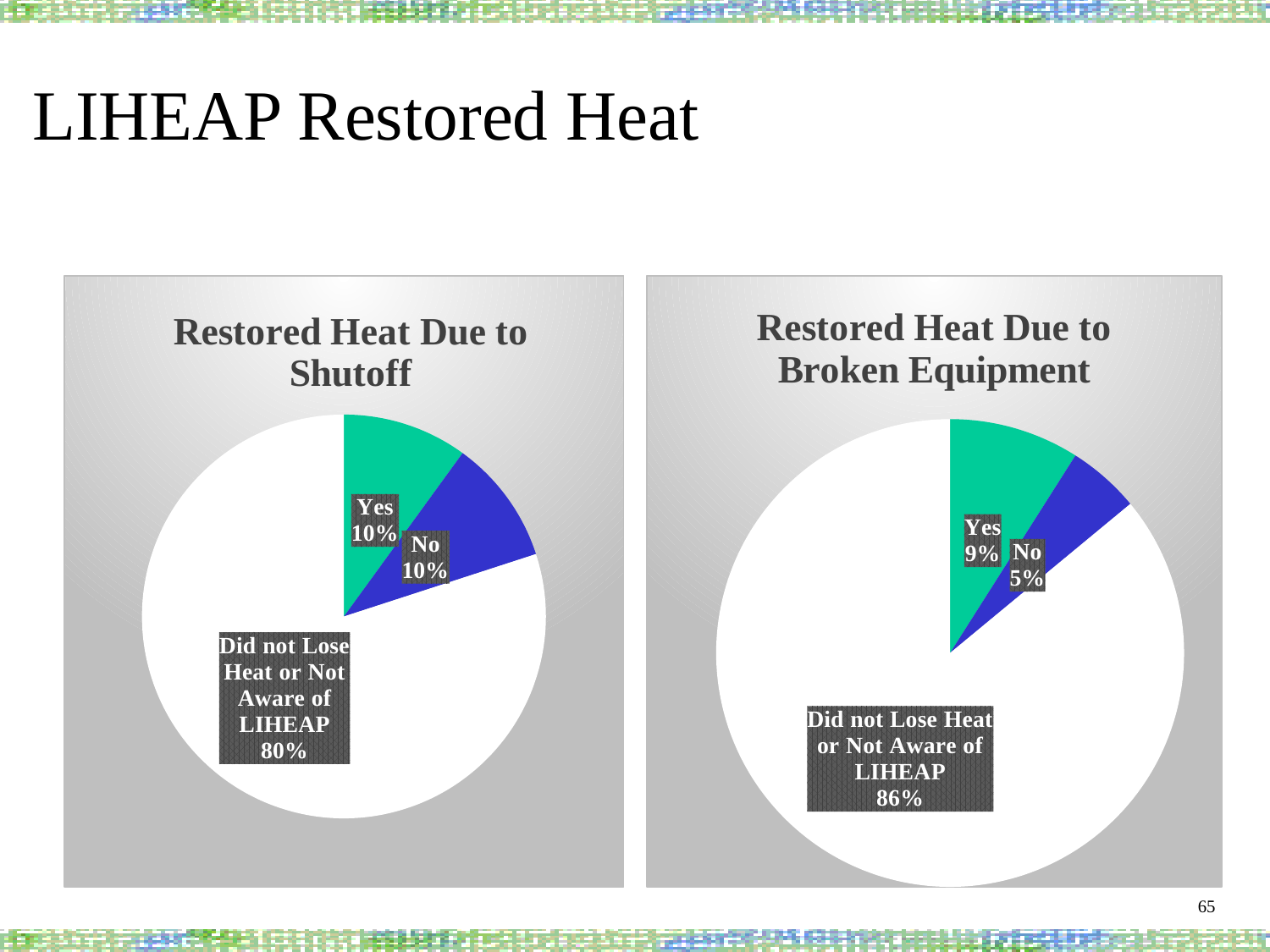
In the 'Restored Heat Due to Shutoff' chart, which slice is the largest? Did not Lose Heat or Not Aware of LIHEAP In the 'Restored Heat Due to Broken Equipment' chart, which slice is the largest? Did not Lose Heat or Not Aware of LIHEAP How many slices does the 'Restored Heat Due to Shutoff' chart have? 3 In the 'Restored Heat Due to Broken Equipment' chart, which slice is the smallest? No In the 'Restored Heat Due to Broken Equipment' chart, what share of the pie is 'Yes'? 9% In the 'Restored Heat Due to Shutoff' chart, what is the value for 'Did not Lose Heat or Not Aware of LIHEAP'? 80% In the 'Restored Heat Due to Broken Equipment' chart, what is the difference between 'Yes' and 'No'? 4% What is the title of the chart on the left side of the slide? Restored Heat Due to Shutoff What type of chart is 'Restored Heat Due to Broken Equipment'? Pie chart In the 'Restored Heat Due to Broken Equipment' chart, which is larger, 'Yes' or 'No'? Yes In the 'Restored Heat Due to Broken Equipment' chart, what is the value for 'No'? 5% In the 'Restored Heat Due to Shutoff' chart, what share of the pie is 'Yes'? 10%